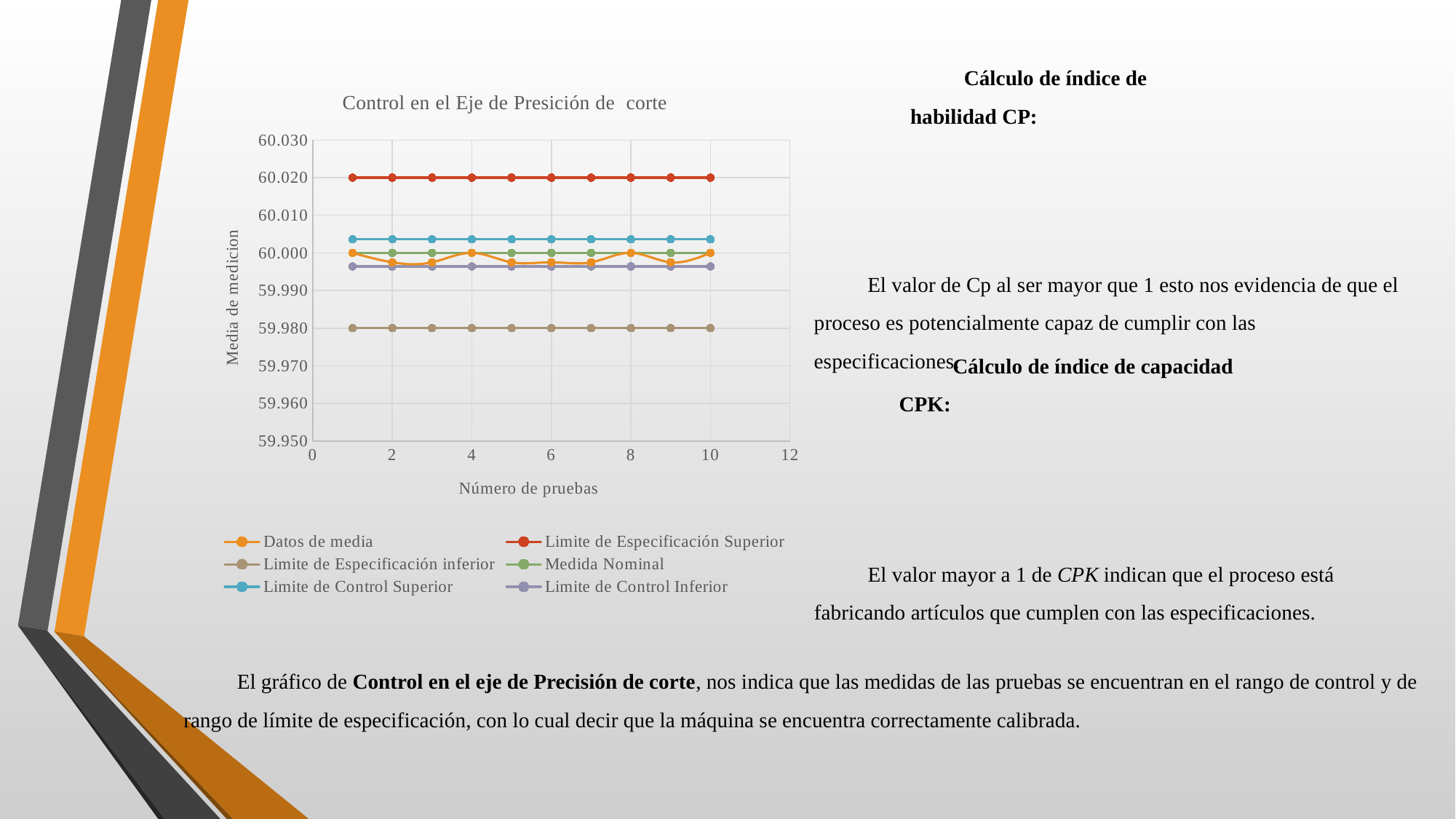
How many test points (pruebas) are plotted for each series? 10 Is the value for Limite de Control Superior greater or less than 60.010? less Which is larger, Limite de Control Superior or Limite de Control Inferior? Limite de Control Superior What is the difference between the Limite de Especificación Superior and the Limite de Especificación inferior? 0.040 What is the value of the Limite de Especificación inferior series? 59.980 What is the value of the Limite de Especificación Superior series? 60.020 What kind of chart is shown on the slide? Line chart Which series has the lowest values on the chart? Limite de Especificación inferior What is the label of the x axis? Número de pruebas How many series does the chart legend list? 6 Which series has the highest values on the chart? Limite de Especificación Superior What is the value of the Medida Nominal series? 60.000